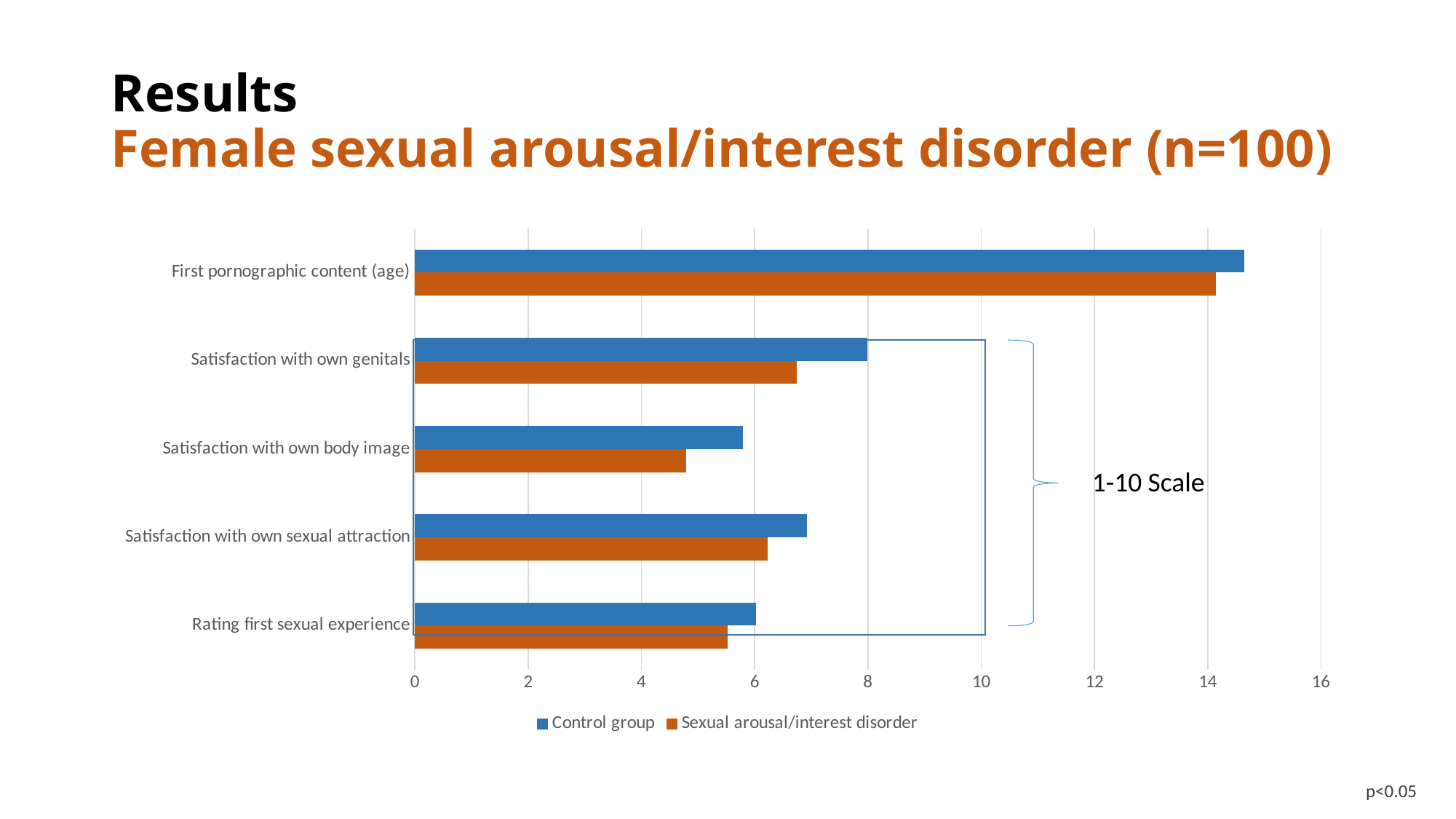
Is the Sexual arousal/interest disorder value for Rating first sexual experience greater or less than 6? less For Satisfaction with own body image, which group has the larger value: Control group or Sexual arousal/interest disorder? Control group For Satisfaction with own genitals, which group has the larger value: Control group or Sexual arousal/interest disorder? Control group Is the Sexual arousal/interest disorder value for Satisfaction with own body image greater or less than 6? less How many categories are plotted on the chart? 5 Is the Control group value for Satisfaction with own sexual attraction greater or less than 6? greater How many series does the legend list? 2 Which category has the lowest value for the Sexual arousal/interest disorder group? Satisfaction with own body image Which category has the highest value for the Control group? First pornographic content (age) What kind of chart is shown on the slide? bar chart What colour are the bars for the Control group? blue